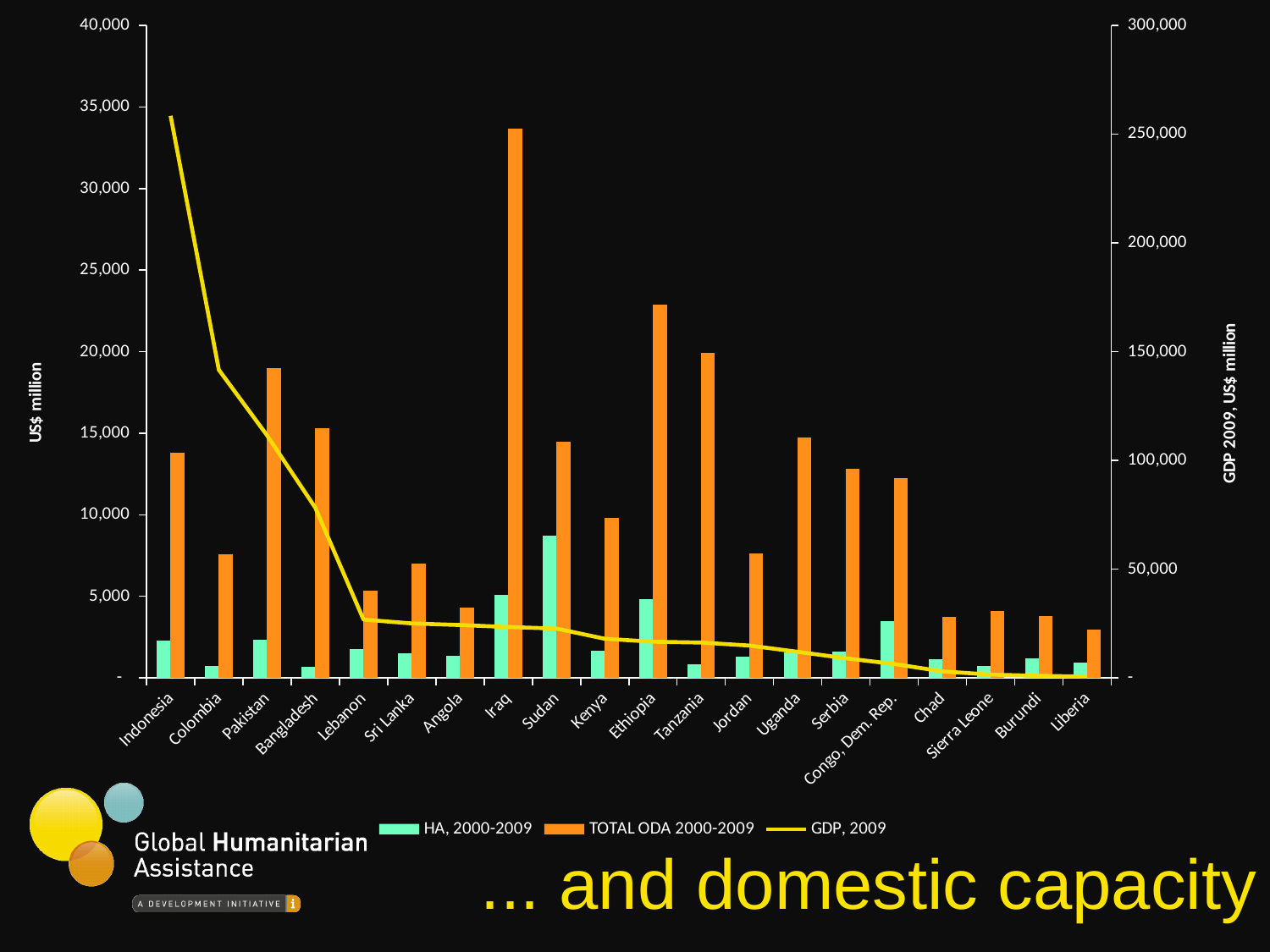
How many series does the legend list? 3 Does the GDP, 2009 line rise or fall from left to right across the countries? Fall Is the TOTAL ODA 2000-2009 value for Pakistan greater or less than 20,000? less Which country has the highest TOTAL ODA 2000-2009? Iraq Is the GDP, 2009 value for Indonesia greater or less than 200,000? greater Which country has the highest HA, 2000-2009 value? Sudan Is the TOTAL ODA 2000-2009 value for Iraq greater or less than 30,000? greater What kind of chart is shown on the slide? A bar chart combined with a line chart How many countries are shown along the x axis? 20 Which has the larger TOTAL ODA 2000-2009, Ethiopia or Tanzania? Ethiopia Which country has the lowest TOTAL ODA 2000-2009? Liberia